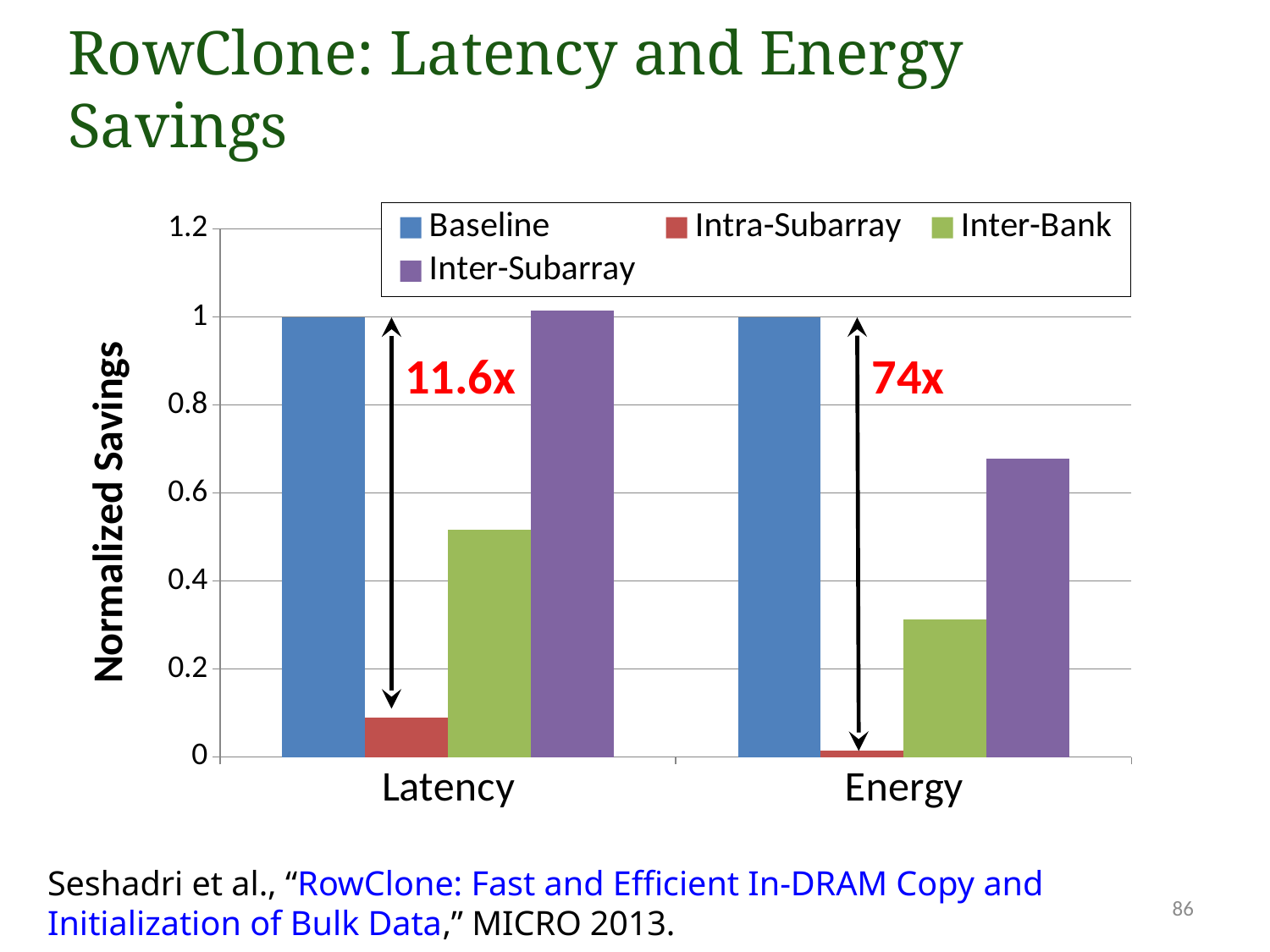
Which series has the lowest value for Latency? Intra-Subarray Is the value for Inter-Subarray under Energy greater or less than 0.8? less Which series has the lowest value for Energy? Intra-Subarray Is the value for Intra-Subarray under Latency greater or less than 0.2? less What is the value of the Baseline bar for Latency? 1 Is the value for Inter-Bank under Latency greater or less than 0.4? greater What is the label on the y axis? Normalized Savings What is the value of the Baseline bar for Energy? 1 How many series does the legend list? 4 What kind of chart is shown on the slide? bar chart How many categories are shown on the x axis? 2 Which is larger: the Inter-Bank value for Latency or the Inter-Bank value for Energy? Latency